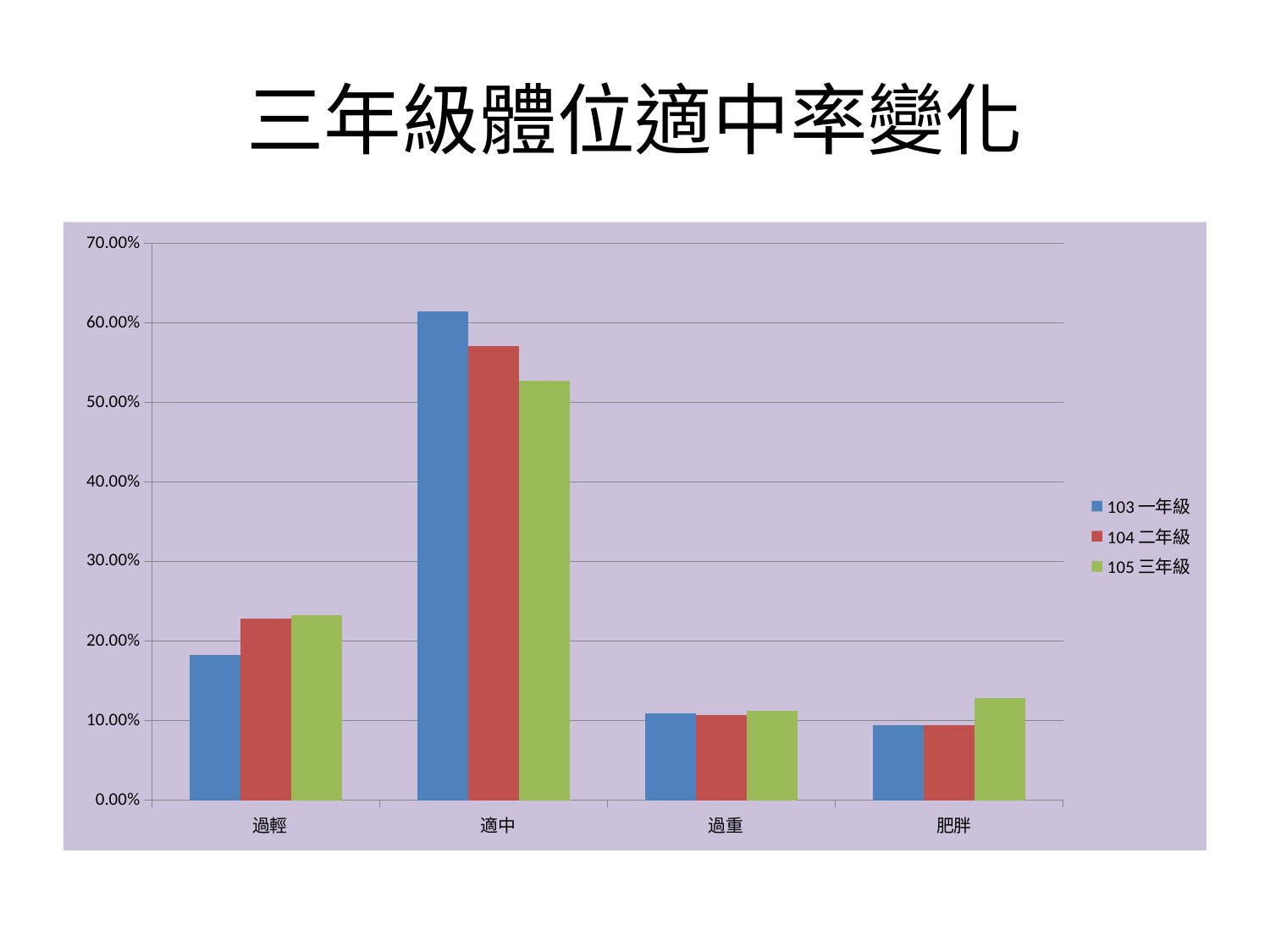
How many categories are shown on the x axis of the chart? 4 What kind of chart is shown on the slide? bar chart How many series does the chart's legend list? 3 Is the value for 適中 in the 105 三年級 series greater or less than 60.00%? less For the 適中 category, which series has the larger value: 103 一年級 or 105 三年級? 103 一年級 For the 適中 category, do the values rise or fall from 103 一年級 to 105 三年級? fall For the 肥胖 category, which series has the larger value: 104 二年級 or 105 三年級? 105 三年級 Is the value for 適中 in the 103 一年級 series greater or less than 50.00%? greater Which category has the lowest value for the 103 一年級 series? 肥胖 Is the value for 過輕 in the 103 一年級 series greater or less than 20.00%? less What is the title of the slide? 三年級體位適中率變化 Which category has the highest value for the 103 一年級 series? 適中